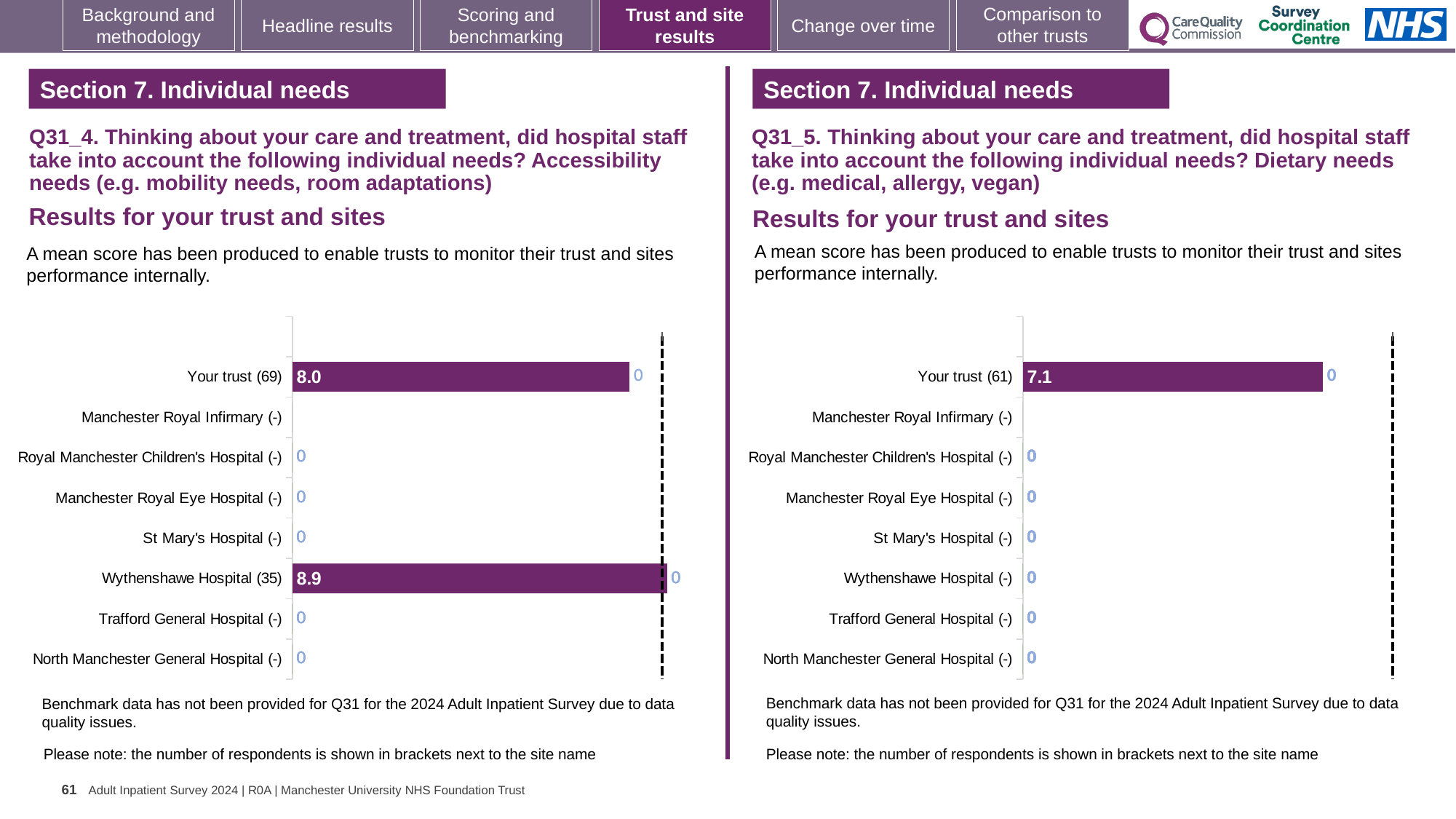
Which is larger: the Your trust score in the Q31_4 chart on the left or the Your trust score in the Q31_5 chart on the right? Q31_4 (8.0) In the Q31_5 chart on the right, how many sites have a plotted bar with a mean score? 1 In the Q31_5 chart on the right, what is the mean score for Your trust? 7.1 In the Q31_5 chart on the right, how many respondents are shown in brackets for Your trust? 61 In the Q31_4 chart on the left, which site has the highest mean score? Wythenshawe Hospital In the Q31_4 chart on the left, which is larger: the score for Your trust or the score for Wythenshawe Hospital? Wythenshawe Hospital In the Q31_4 chart on the left, what is the mean score for Your trust? 8.0 In the Q31_4 chart on the left, what is the mean score for Wythenshawe Hospital? 8.9 How many site categories are listed on the y axis of the Q31_5 chart on the right? 8 In the Q31_4 chart on the left, what is the difference between the Wythenshawe Hospital score and the Your trust score? 0.9 What type of chart is used in the Q31_4 chart on the left? Bar chart In the Q31_4 chart on the left, how many respondents are shown in brackets for Wythenshawe Hospital? 35